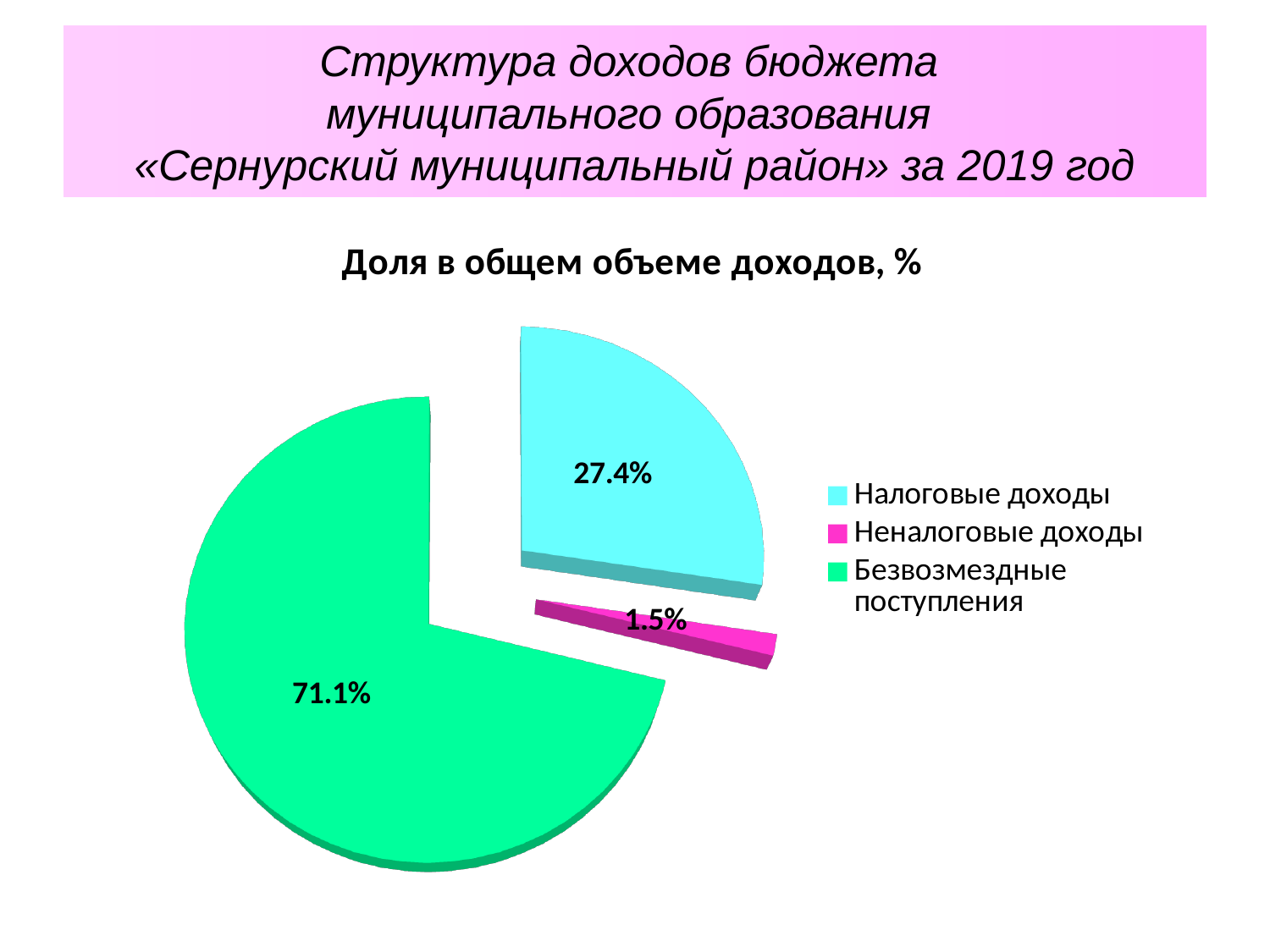
What share of total revenue do Безвозмездные поступления account for? 71.1% What colour is the slice for Безвозмездные поступления? Green What is the difference in percentage points between Налоговые доходы and Неналоговые доходы? 25.9 How many slices does the pie chart have? 3 Which category has the largest share of the pie? Безвозмездные поступления Which is larger: the share of Налоговые доходы or the share of Неналоговые доходы? Налоговые доходы What share of total revenue do Неналоговые доходы account for? 1.5% What is the difference in percentage points between Безвозмездные поступления and Налоговые доходы? 43.7 What kind of chart is shown on the slide? Pie chart Which category has the smallest share of the pie? Неналоговые доходы What is the title of the chart? Доля в общем объеме доходов, % What share of total revenue do Налоговые доходы account for? 27.4%